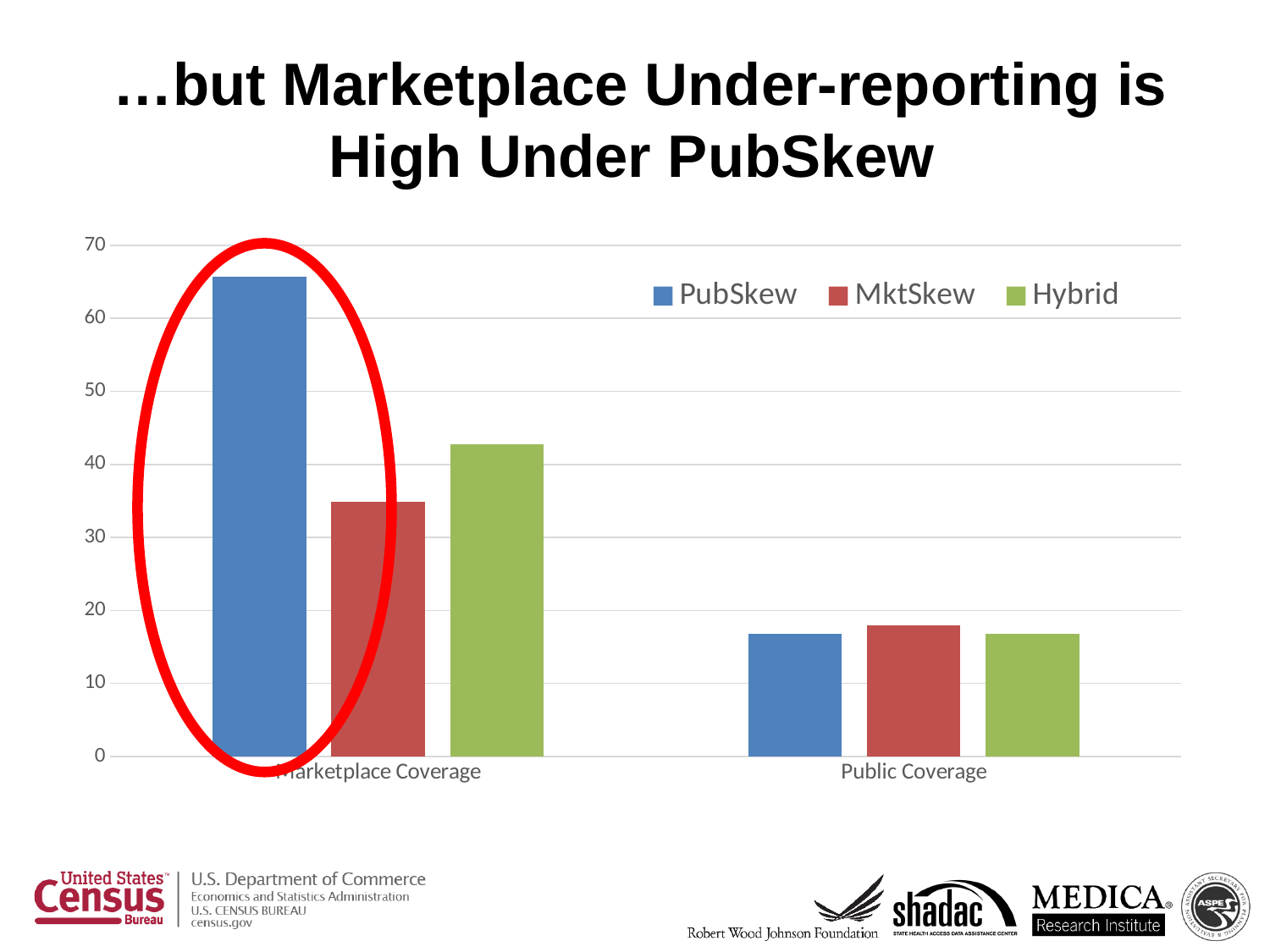
How many categories are shown on the x axis? 2 Is the Hybrid value for Marketplace Coverage greater or less than 40? greater Which category's bars are circled in red on the slide? Marketplace Coverage (the PubSkew bar) Is the MktSkew value for Marketplace Coverage greater or less than 40? less What kind of chart is shown on the slide? bar chart For Marketplace Coverage, which is larger: the Hybrid value or the MktSkew value? Hybrid Which series is shown in green in the legend? Hybrid How many series does the legend list? 3 Is the PubSkew value for Public Coverage greater or less than 20? less Which series has the lowest value for Marketplace Coverage? MktSkew Which series has the highest value for Marketplace Coverage? PubSkew